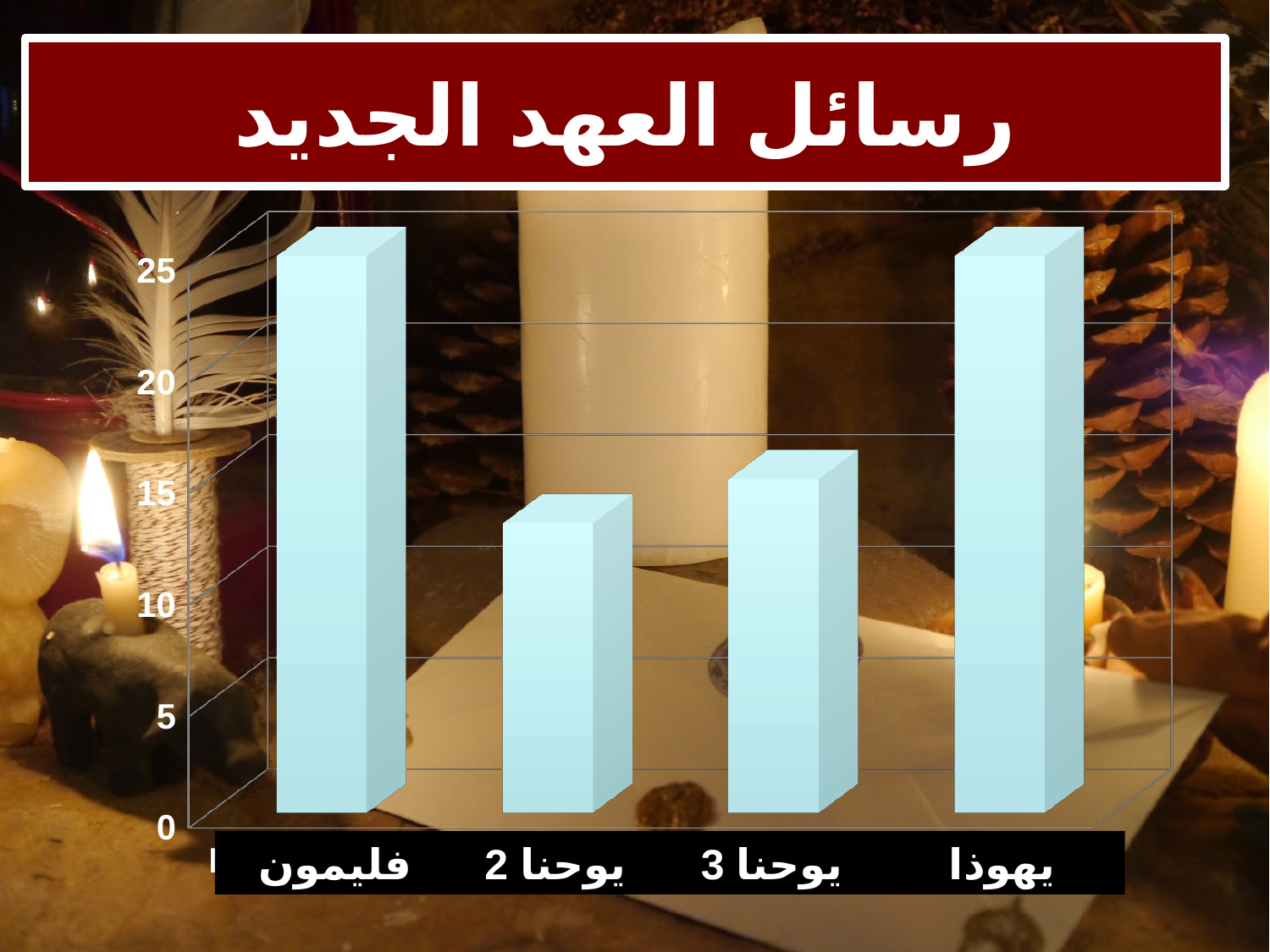
How many categories are shown on the x axis of the chart? 4 Is the value for يهوذا greater or less than 20? greater What is the title of the slide? رسائل العهد الجديد Is the value for يوحنا 3 greater or less than 20? less What is the highest value shown on the y axis of the chart? 25 Is the value for يوحنا 2 greater or less than 10? greater Which category has the lowest bar in the chart? يوحنا 2 What kind of chart is shown on the slide? bar chart Which is larger, the value for يوحنا 2 or the value for يوحنا 3? يوحنا 3 Which is larger, the value for فليمون or the value for يوحنا 3? فليمون